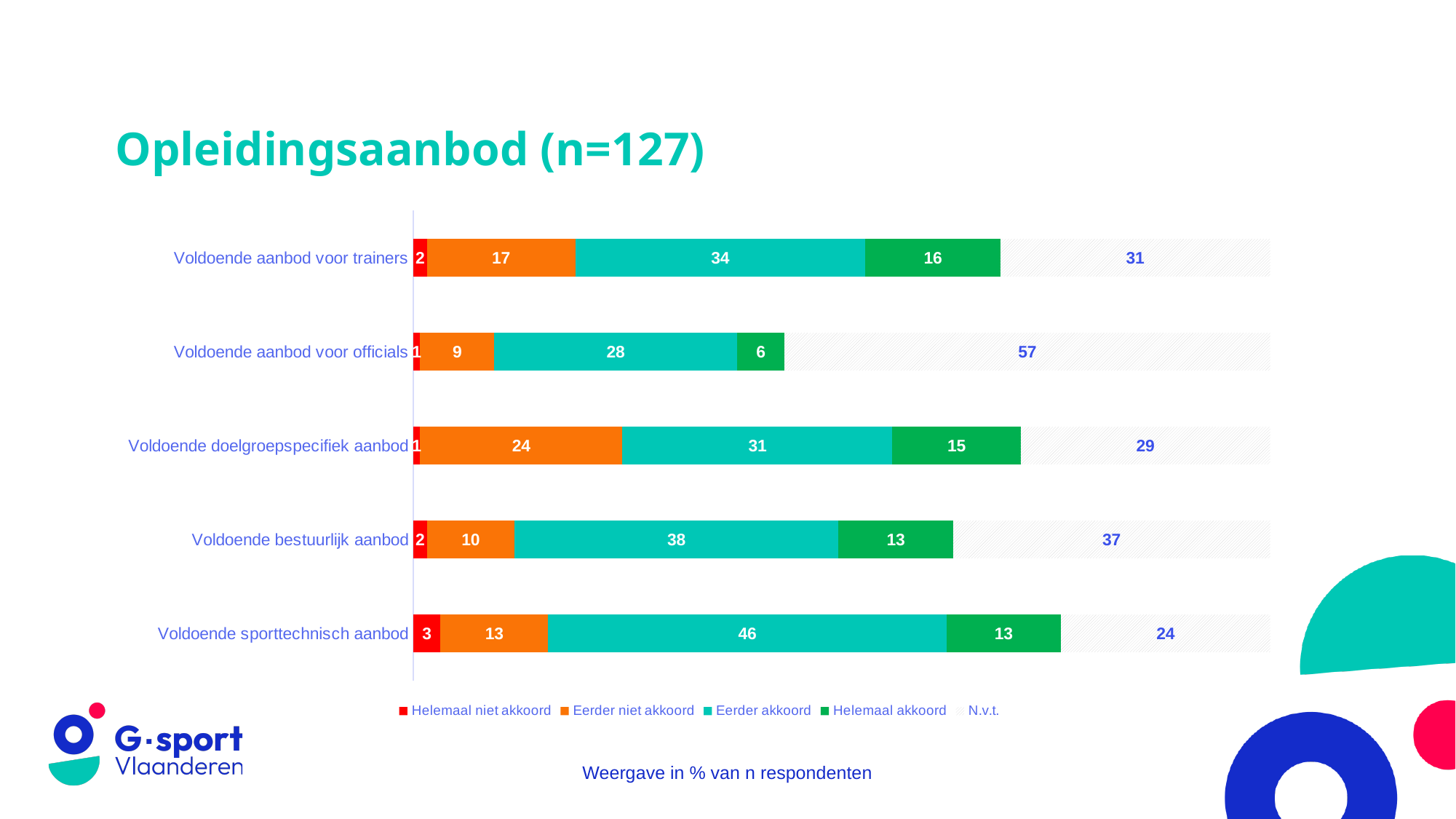
Which category has the lowest 'Helemaal akkoord' value? Voldoende aanbod voor officials What is the total of the stacked bar for 'Voldoende aanbod voor trainers'? 100 What is the 'N.v.t.' value for 'Voldoende aanbod voor officials'? 57 What is the value of 'Eerder akkoord' for 'Voldoende sporttechnisch aanbod'? 46 How many series does the legend list? 5 Which has the larger 'N.v.t.' value: 'Voldoende bestuurlijk aanbod' or 'Voldoende aanbod voor trainers'? Voldoende bestuurlijk aanbod What is the 'Helemaal niet akkoord' value for 'Voldoende sporttechnisch aanbod'? 3 How many categories are shown in the chart? 5 Which category has the highest 'Eerder akkoord' value? Voldoende sporttechnisch aanbod What is the difference between the 'Eerder niet akkoord' values for 'Voldoende doelgroepspecifiek aanbod' and 'Voldoende aanbod voor trainers'? 7 What is the title of the slide? Opleidingsaanbod (n=127) What type of chart is shown on the slide? Stacked bar chart